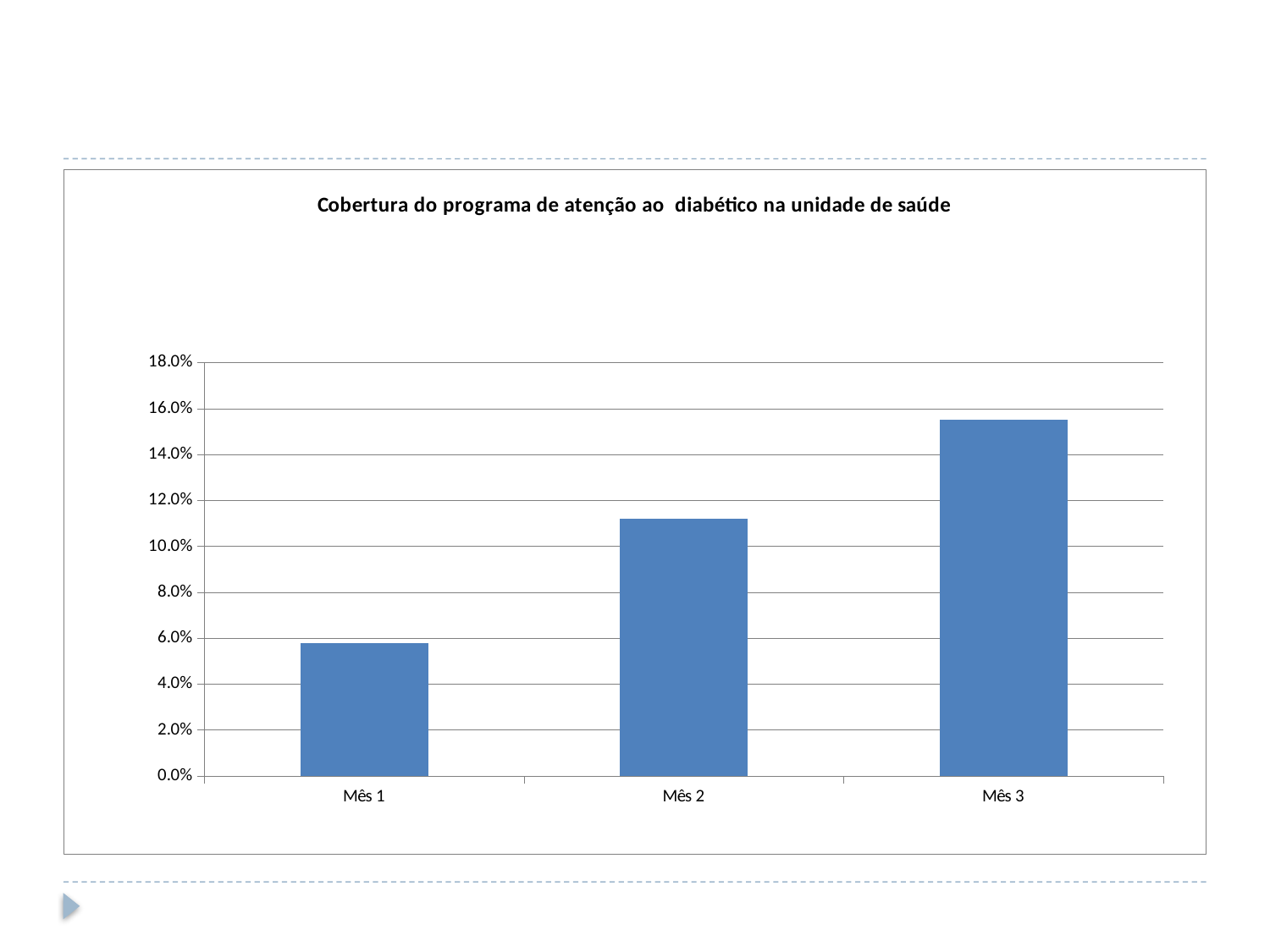
Is the value for Mês 3 greater or less than 14.0%? greater Is the value for Mês 3 greater or less than 16.0%? less What is the title of the chart? Cobertura do programa de atenção ao diabético na unidade de saúde Which category has the lowest value? Mês 1 Do the values rise or fall from Mês 1 to Mês 3? rise Which is larger, the value for Mês 1 or the value for Mês 2? Mês 2 Is the value for Mês 1 greater or less than 6.0%? less What is the highest value shown on the y axis? 18.0% Which category has the highest value? Mês 3 What kind of chart is shown on the slide? bar chart How many categories are shown on the x axis? 3